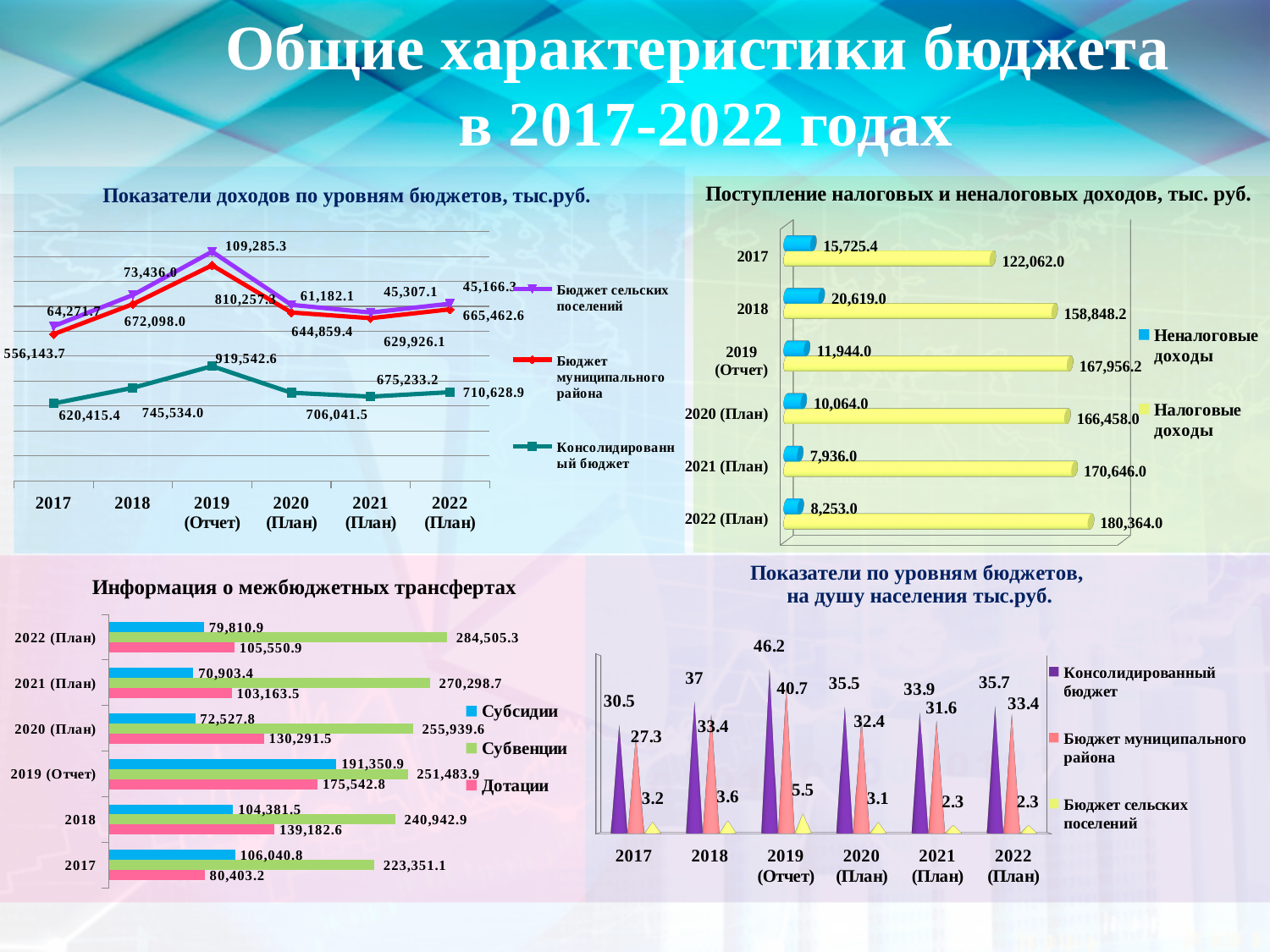
In the chart 'Информация о межбюджетных трансфертах', what is the value of Субвенции for 2020 (План)? 255,939.6 In the chart 'Показатели доходов по уровням бюджетов, тыс.руб.', in which year does Бюджет сельских поселений reach its highest value? 2019 (Отчет) In the chart 'Информация о межбюджетных трансфертах', how many years are shown on the axis? 6 In the chart 'Информация о межбюджетных трансфертах', which is larger for 2019 (Отчет): Субсидии or Дотации? Субсидии In the chart 'Показатели по уровням бюджетов, на душу населения тыс.руб.', what is the value of Бюджет муниципального района for 2019 (Отчет)? 40.7 In the chart 'Поступление налоговых и неналоговых доходов, тыс. руб.', what is the difference between Налоговые доходы in 2018 and 2017? 36,786.2 In the chart 'Поступление налоговых и неналоговых доходов, тыс. руб.', which year has the lowest Неналоговые доходы? 2021 (План) In the chart 'Поступление налоговых и неналоговых доходов, тыс. руб.', what is the value of Налоговые доходы for 2022 (План)? 180,364.0 In the chart 'Показатели доходов по уровням бюджетов, тыс.руб.', how many series does the legend list? 3 In the chart 'Показатели по уровням бюджетов, на душу населения тыс.руб.', what is the difference between Консолидированный бюджет and Бюджет муниципального района in 2017? 3.2 In the chart 'Показатели доходов по уровням бюджетов, тыс.руб.', what is the value of Консолидированный бюджет for 2019 (Отчет)? 919,542.6 What type of chart is 'Показатели доходов по уровням бюджетов, тыс.руб.'? Line chart